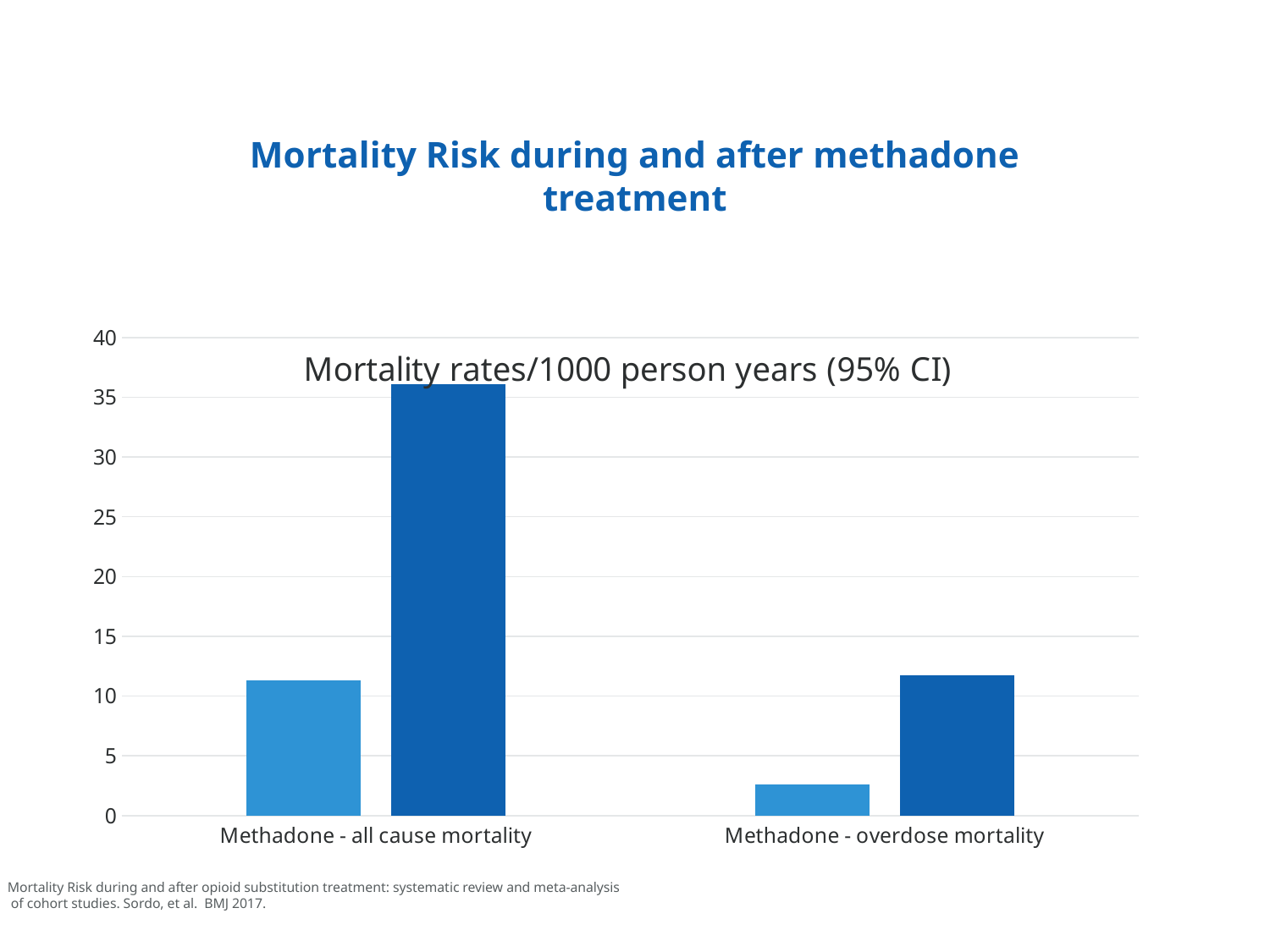
Is the dark blue bar for "Methadone - overdose mortality" greater or less than 10? greater Is the dark blue bar for "Methadone - all cause mortality" greater or less than 35? greater What is the title printed inside the chart area? Mortality rates/1000 person years (95% CI) How many categories are shown on the x axis of the chart? 2 What is the highest value shown on the y axis of the chart? 40 Is the light blue bar for "Methadone - all cause mortality" greater or less than 10? greater What kind of chart is shown on the slide? bar chart Which bar is the tallest in the chart? the dark blue bar for Methadone - all cause mortality Which bar is the shortest in the chart? the light blue bar for Methadone - overdose mortality Within "Methadone - overdose mortality", which bar is taller, the light blue or the dark blue? dark blue Which category has the taller light blue bar, "Methadone - all cause mortality" or "Methadone - overdose mortality"? Methadone - all cause mortality